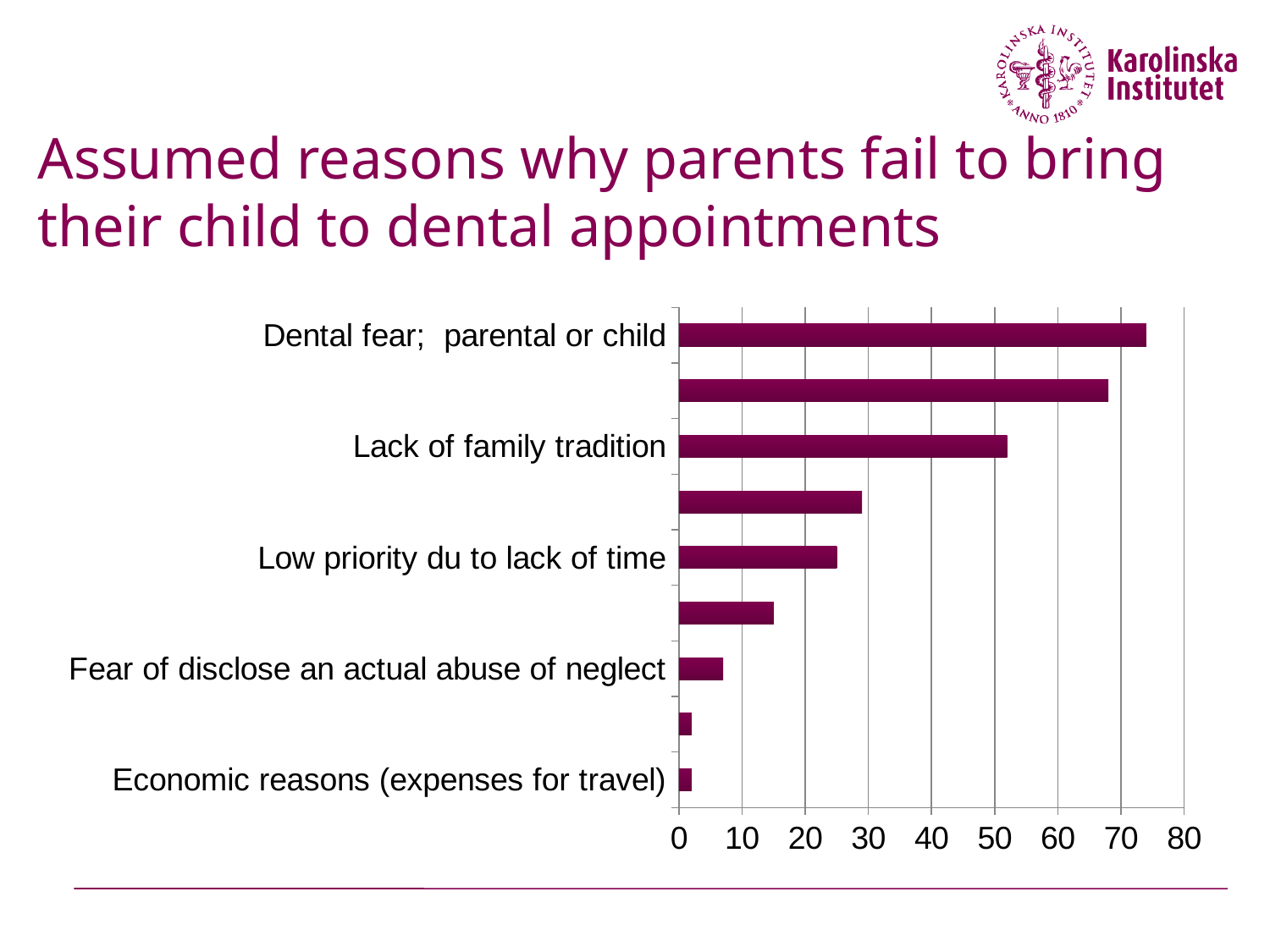
What kind of chart is shown on the slide? bar chart Is the value for 'Dental fear; parental or child' greater or less than 70? greater Is the value for 'Low priority du to lack of time' greater or less than 30? less Which is larger: the value for 'Low priority du to lack of time' or for 'Fear of disclose an actual abuse of neglect'? Low priority du to lack of time Which category has the highest value in the chart? Dental fear; parental or child Is the value for 'Fear of disclose an actual abuse of neglect' greater or less than 10? less Which is larger: the value for 'Dental fear; parental or child' or for 'Lack of family tradition'? Dental fear; parental or child What is the maximum value shown on the horizontal axis of the chart? 80 How many bars are plotted in the chart? 9 What is the title of the slide containing the chart? Assumed reasons why parents fail to bring their child to dental appointments